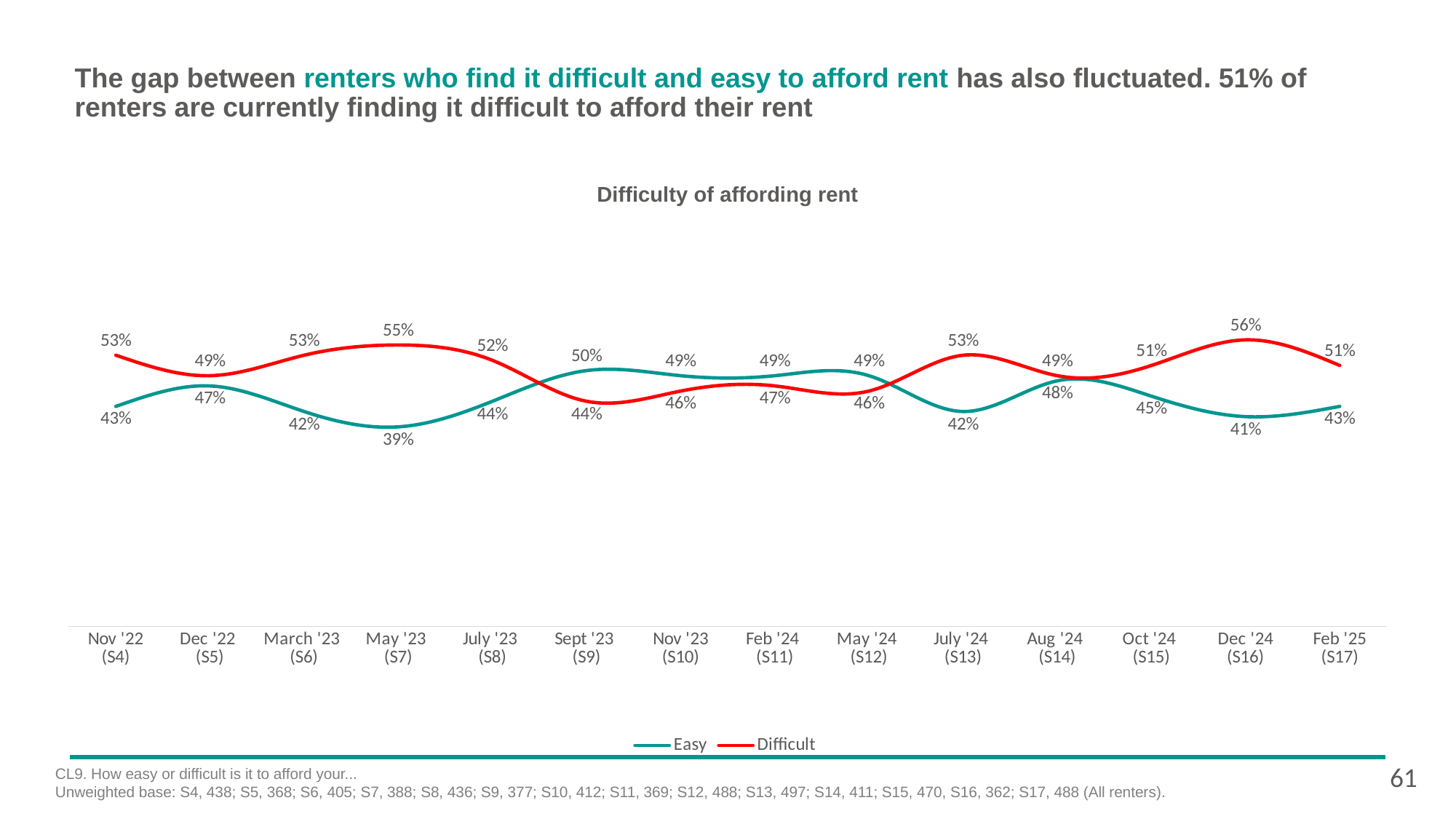
What kind of chart is shown on the slide? Line chart What is the value for Easy in May '23 (S7)? 39% How many time periods are shown on the x axis? 14 What is the value for Difficult in Feb '25 (S17)? 51% What is the difference between the Difficult and Easy values in Dec '24 (S16)? 15 percentage points In which period does the Easy series reach its lowest value? May '23 (S7) In which period does the Difficult series reach its highest value? Dec '24 (S16) In which period does the Easy series reach its highest value? Sept '23 (S9) Which series has the larger value in Nov '23 (S10), Easy or Difficult? Easy What is the title of the chart? Difficulty of affording rent How many series does the legend list? 2 What is the value for Difficult in Sept '23 (S9)? 44%